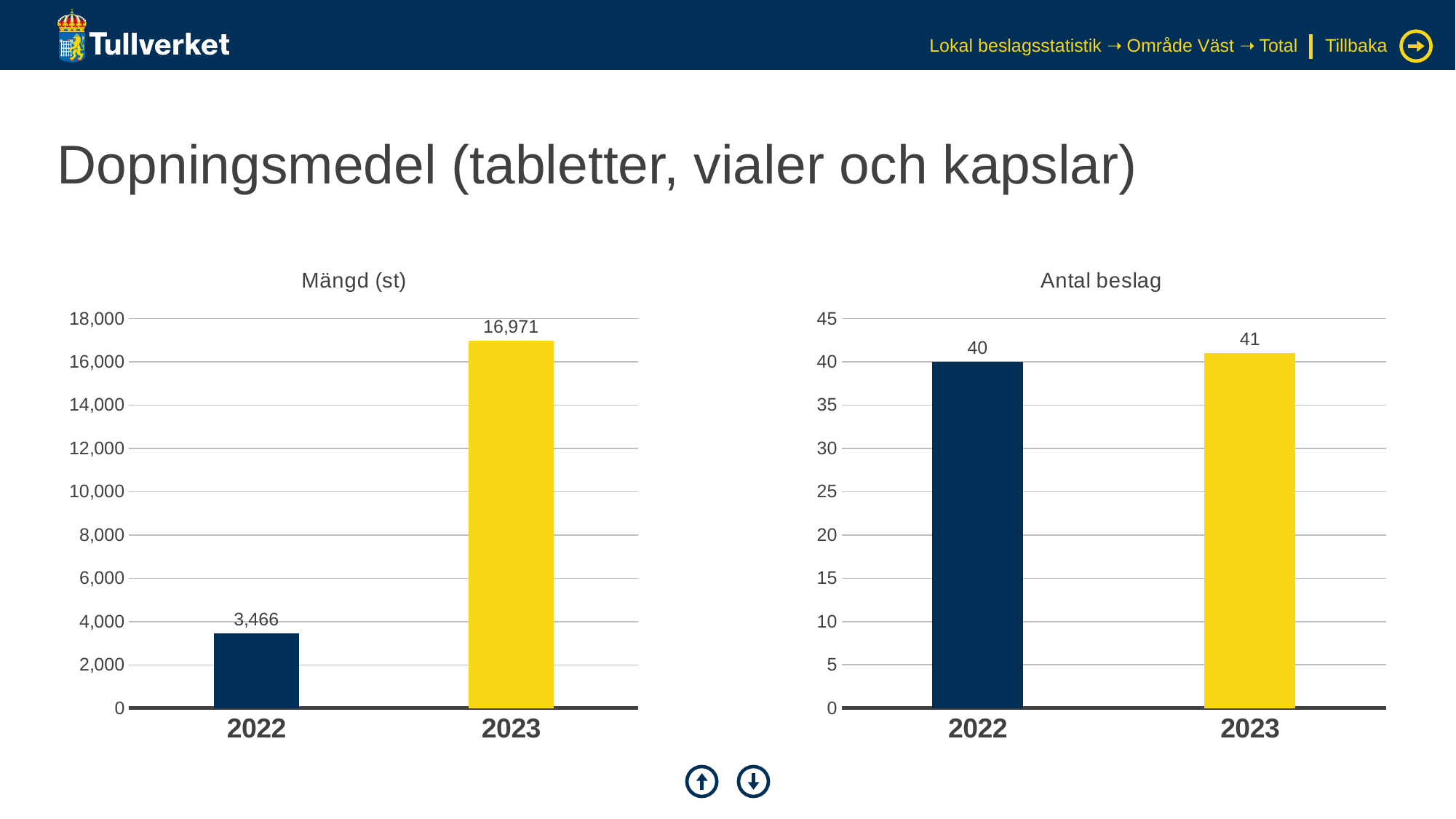
In the 'Mängd (st)' chart, what is the value for 2022? 3,466 In the 'Mängd (st)' chart, which year has the highest value? 2023 What kind of chart is the 'Mängd (st)' chart? bar chart In the 'Mängd (st)' chart, do the values rise or fall from 2022 to 2023? rise In the 'Antal beslag' chart, what is the difference between the 2023 and 2022 values? 1 In the 'Antal beslag' chart, what is the value for 2023? 41 In the 'Mängd (st)' chart, what is the difference between the 2023 and 2022 values? 13,505 In the 'Mängd (st)' chart, is the value for 2022 greater or less than 4,000? less In the 'Mängd (st)' chart, what is the value for 2023? 16,971 What is the title of the chart on the right side of the slide? Antal beslag In the 'Antal beslag' chart, what is the value for 2022? 40 In the 'Antal beslag' chart, how many years are shown on the x axis? 2